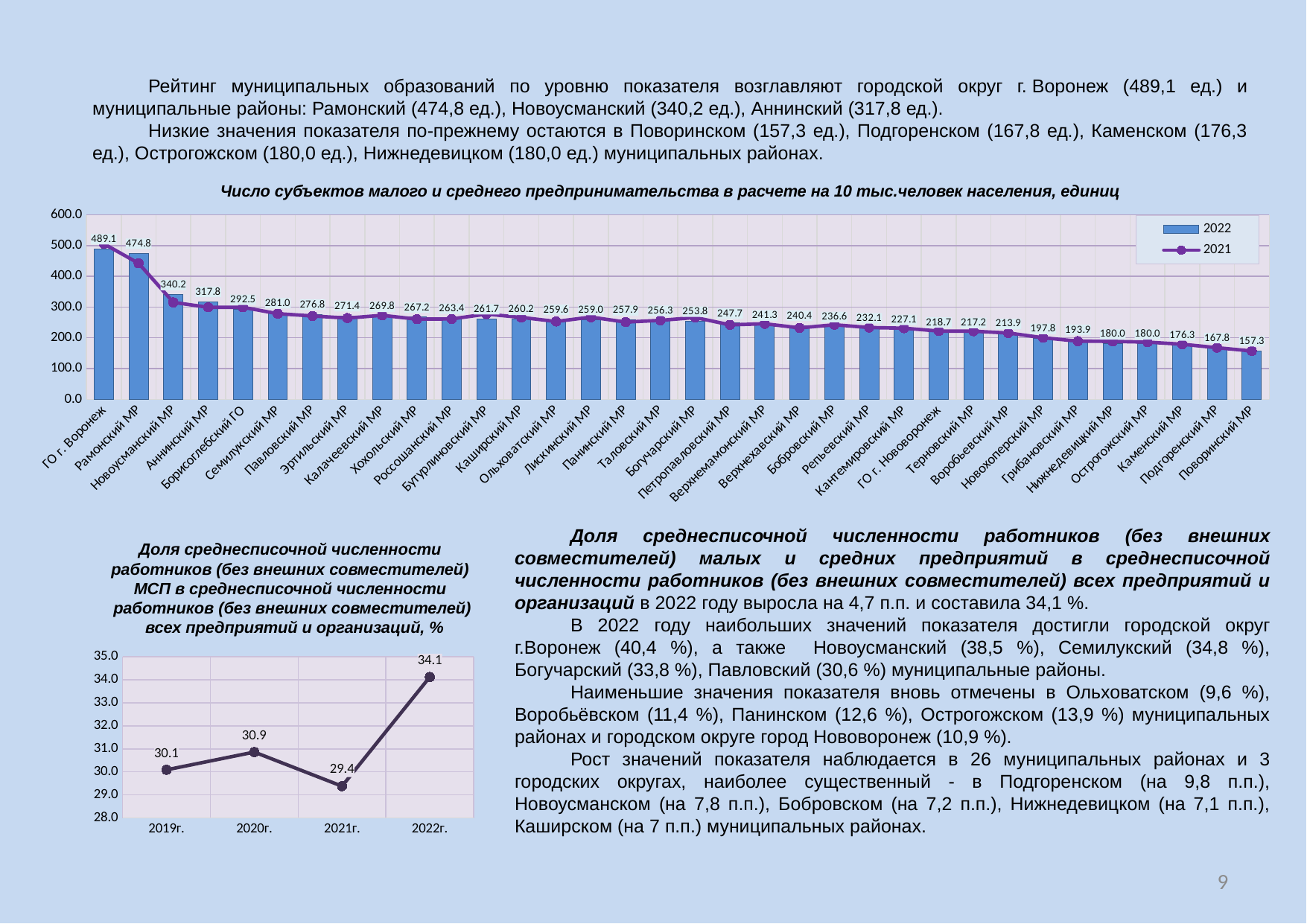
In the top chart, what is the difference between the 2022 values for Рамонский МР and Новоусманский МР? 134.6 In the top chart, is the 2021 value for Рамонский МР greater or less than 400.0? greater In the top chart, which category has the highest 2022 value? ГО г. Воронеж In the top chart, what is the 2022 value for ГО г. Воронеж? 489.1 In the top chart, which category has the lowest 2022 value? Поворинский МР In the bottom-left chart, what is the value for 2022г.? 34.1 In the top chart, how many categories are shown on the x axis? 34 In the top chart, what is the 2022 value for Семилукский МР? 281.0 In the top chart, which has the larger 2022 value, Бобровский МР or Терновский МР? Бобровский МР What kind of chart is the bottom-left chart? line chart In the bottom-left chart, what is the difference between the values for 2022г. and 2021г.? 4.7 In the top chart, how many series does the legend list? 2